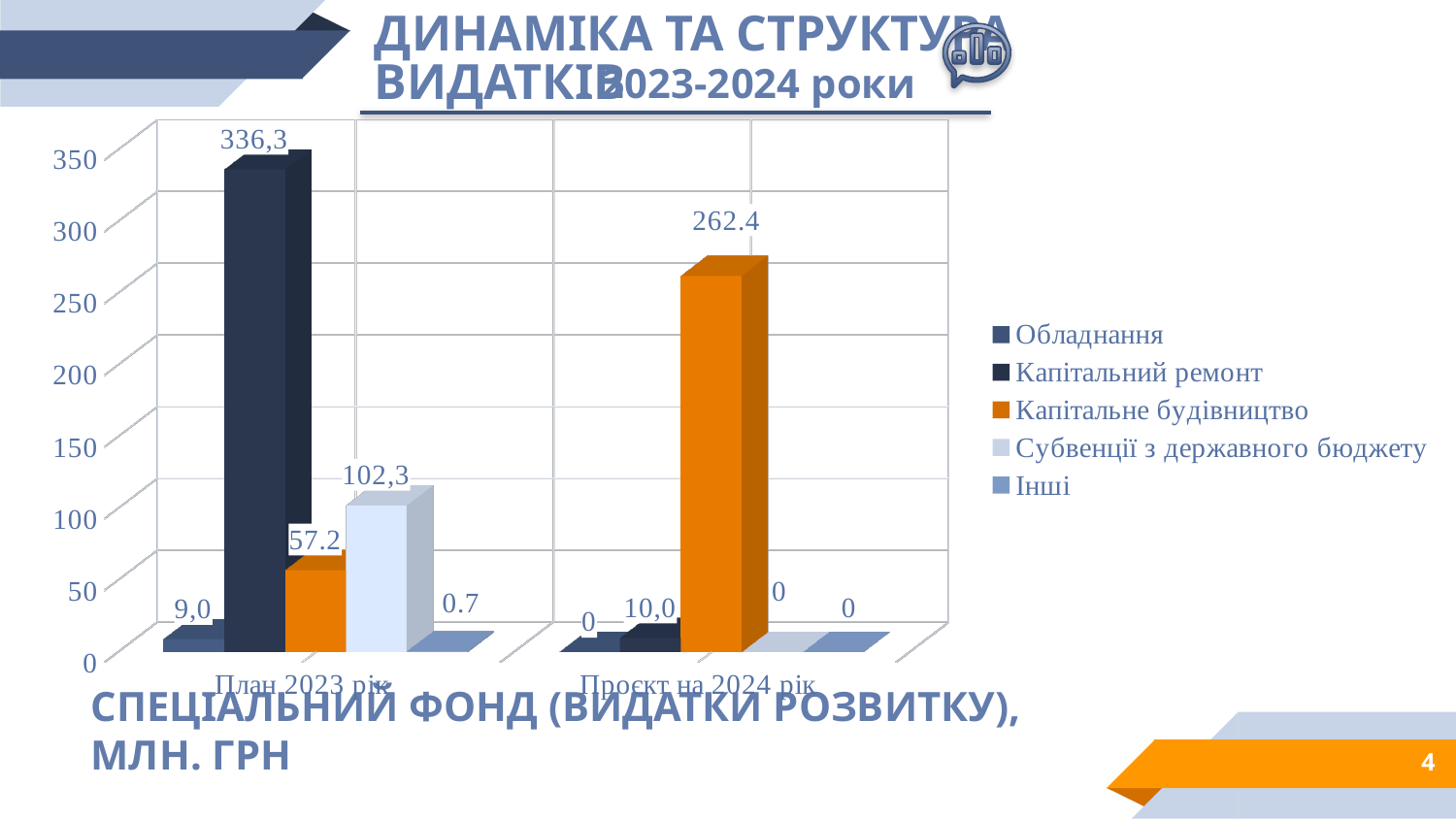
What kind of chart is shown on the slide? Bar chart What is the value for Капітальний ремонт in План 2023 рік? 336,3 How many categories are shown on the x axis? 2 What is the value for Капітальне будівництво in Проєкт на 2024 рік? 262.4 What is the difference between Капітальне будівництво in Проєкт на 2024 рік and Капітальне будівництво in План 2023 рік? 205.2 What is the value for Субвенції з державного бюджету in План 2023 рік? 102,3 Which series has the highest value in Проєкт на 2024 рік? Капітальне будівництво How many series does the legend list? 5 What is the difference between Капітальний ремонт in План 2023 рік and Капітальний ремонт in Проєкт на 2024 рік? 326,3 Which series has the highest value in План 2023 рік? Капітальний ремонт In План 2023 рік, which is larger: Субвенції з державного бюджету or Капітальне будівництво? Субвенції з державного бюджету What is the value for Обладнання in Проєкт на 2024 рік? 0